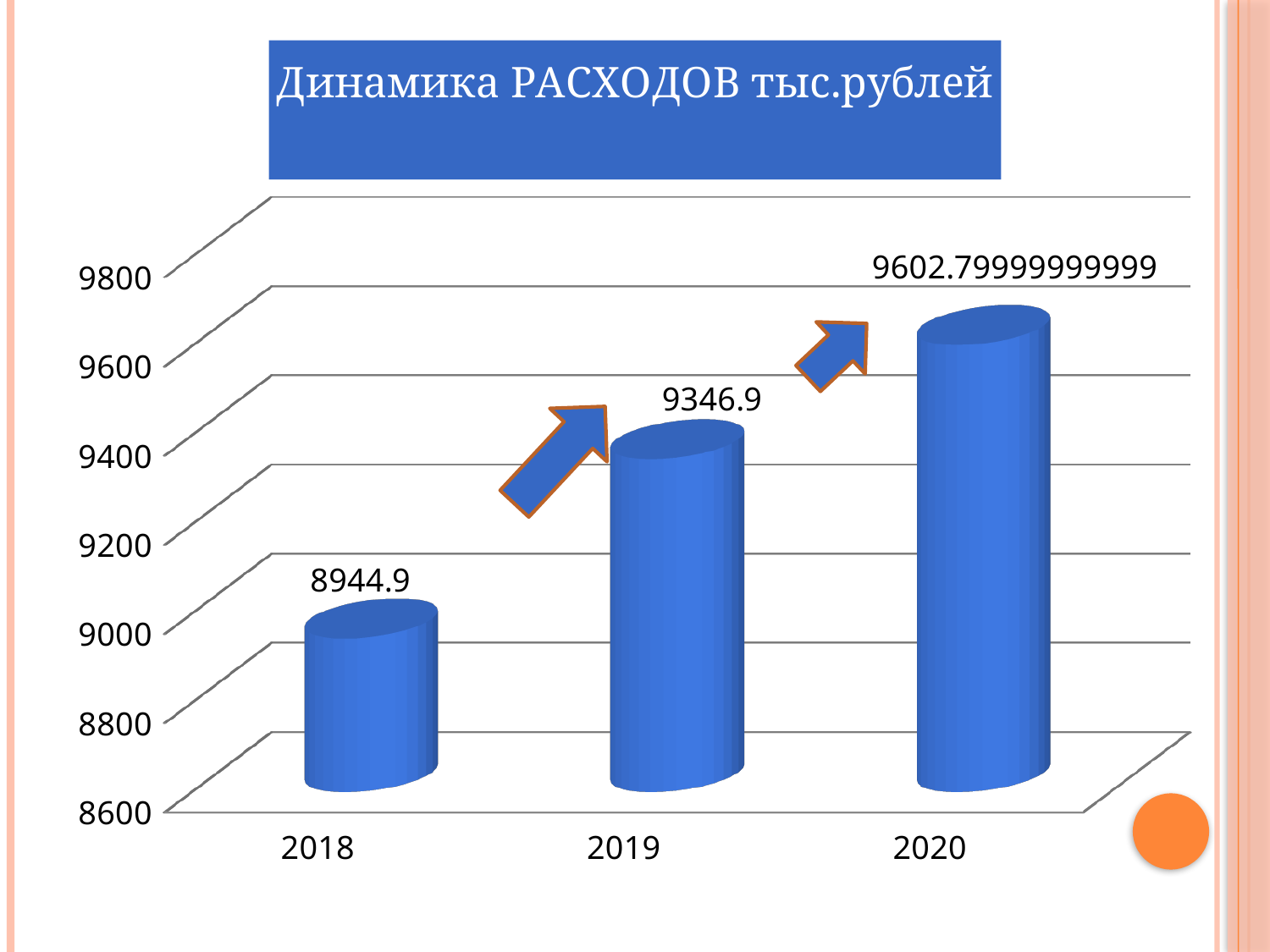
What is the value for 2019? 9346.9 What is the difference between the values for 2019 and 2018? 402 What is the value for 2018? 8944.9 Do the values rise or fall from 2018 to 2020? rise What kind of chart is shown on the slide? bar chart Which year has the highest value? 2020 How many years are shown on the x axis? 3 Is the value for 2020 greater or less than 9400? greater Is the value for 2018 greater or less than 9000? less Which year has the lowest value? 2018 What is the value shown for 2020? 9602.79999999999 Which is larger, the value for 2019 or the value for 2020? 2020